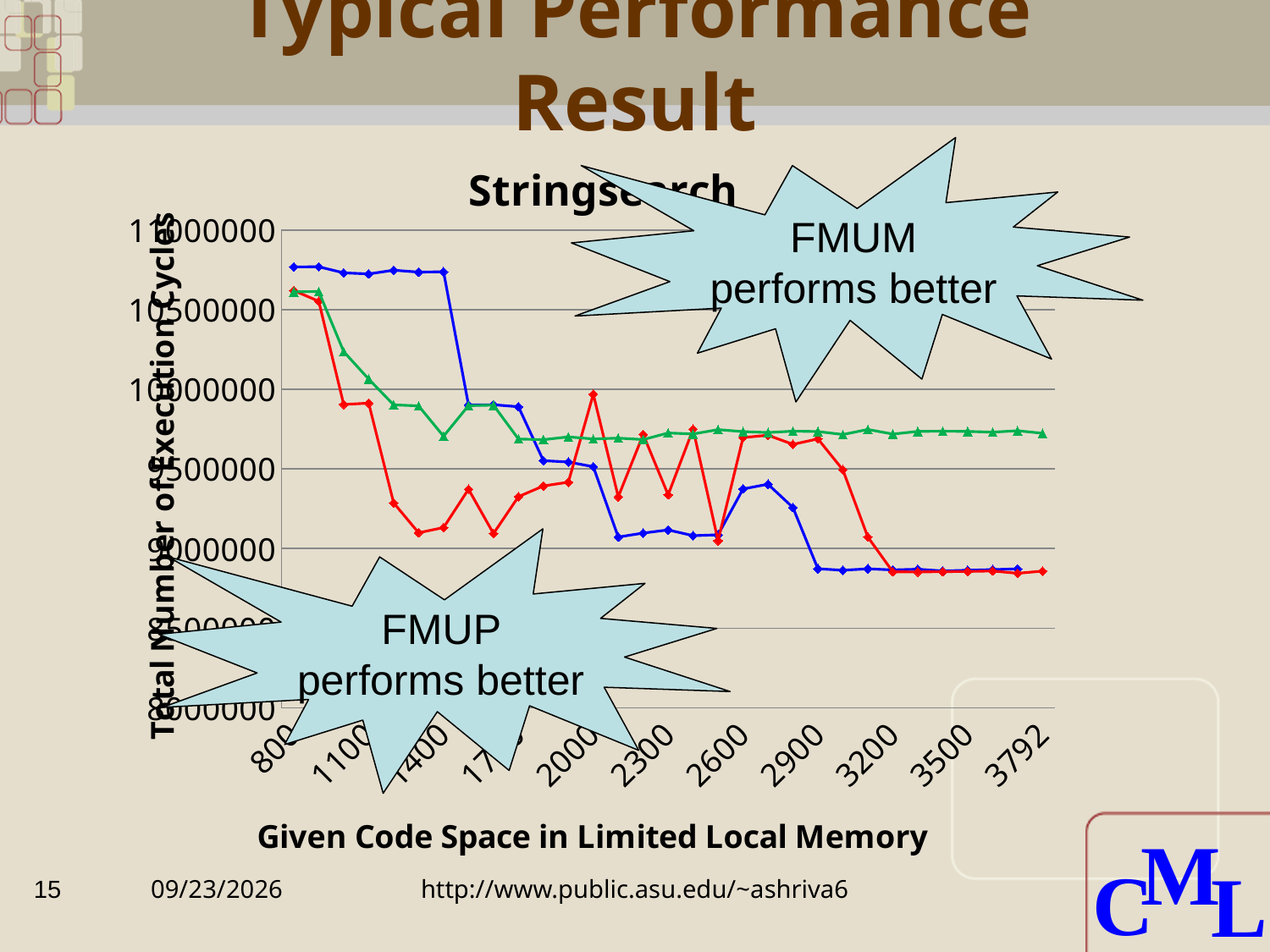
At 3792, which line has the higher value, the green line or the red line? green line How many lines (series) are plotted on the chart? 3 What is the title of the chart? Stringsearch What kind of chart is shown on the slide? line chart Is the value of the green line at 3792 greater or less than 9500000? greater What is the x-axis title of the chart? Given Code Space in Limited Local Memory Is the value of the green line at 2000 greater or less than 9500000? greater Is the value of the blue line at 800 greater or less than 10500000? greater Do the plotted values generally rise or fall as the code space increases along the x axis? fall How many labelled points are there along the x axis of the chart? 11